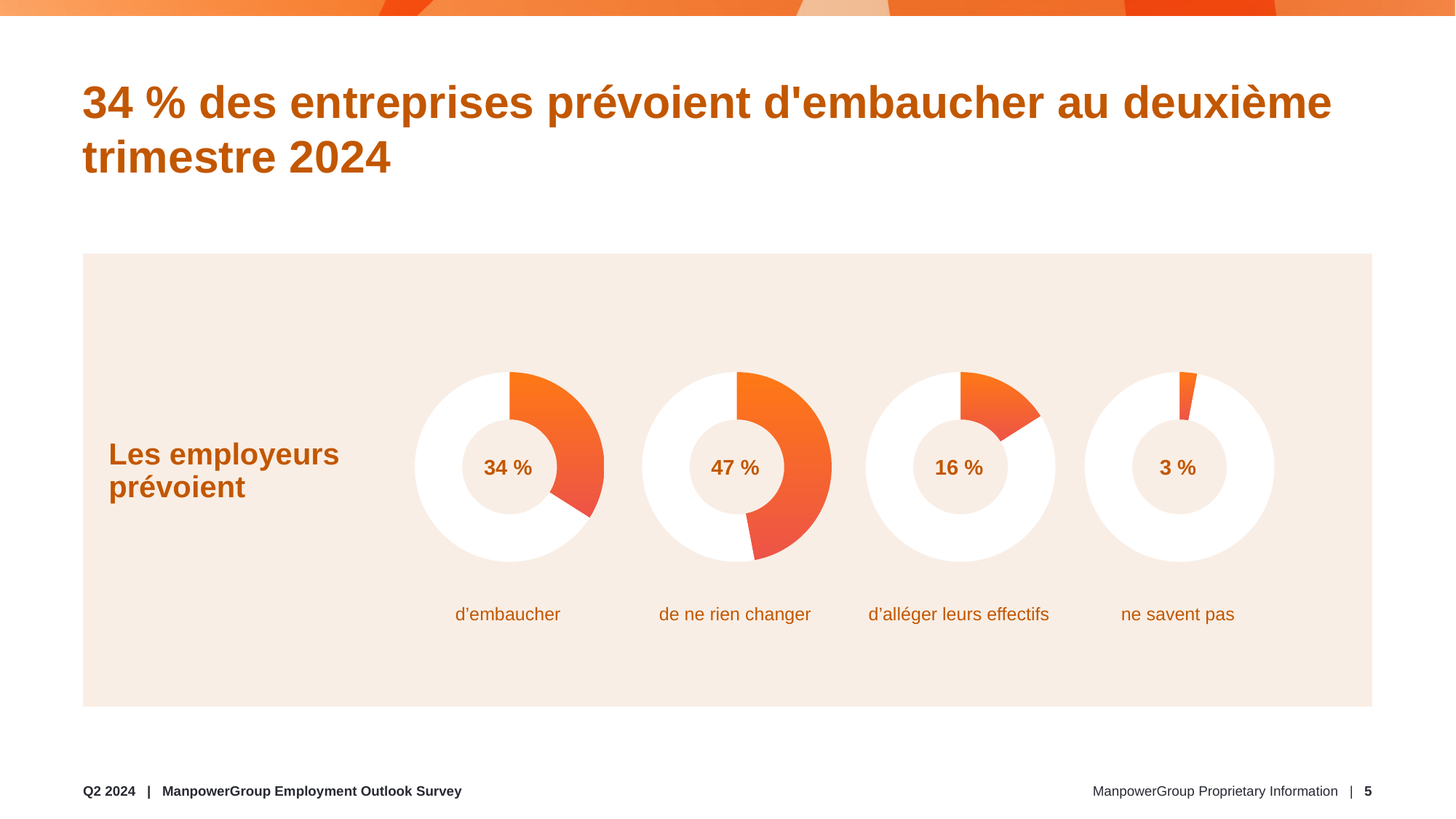
What percentage of employers plan to make no change (de ne rien changer)? 47 % What percentage of employers do not know (ne savent pas)? 3 % Which employer intention has the highest percentage? de ne rien changer What is the difference between the share planning no change and the share planning to hire? 13 % Which is larger: the share planning to hire or the share planning to reduce their workforce? d'embaucher What is the label to the left of the charts describing what the percentages represent? Les employeurs prévoient What percentage of employers plan to reduce their workforce (d'alléger leurs effectifs)? 16 % Which employer intention has the lowest percentage? ne savent pas What kind of chart is used to show each employer intention? Donut (pie) chart What is the difference between the share planning to hire and the share planning to reduce their workforce? 18 % What percentage of employers plan to hire (d'embaucher)? 34 % How many donut charts are shown on the slide? 4